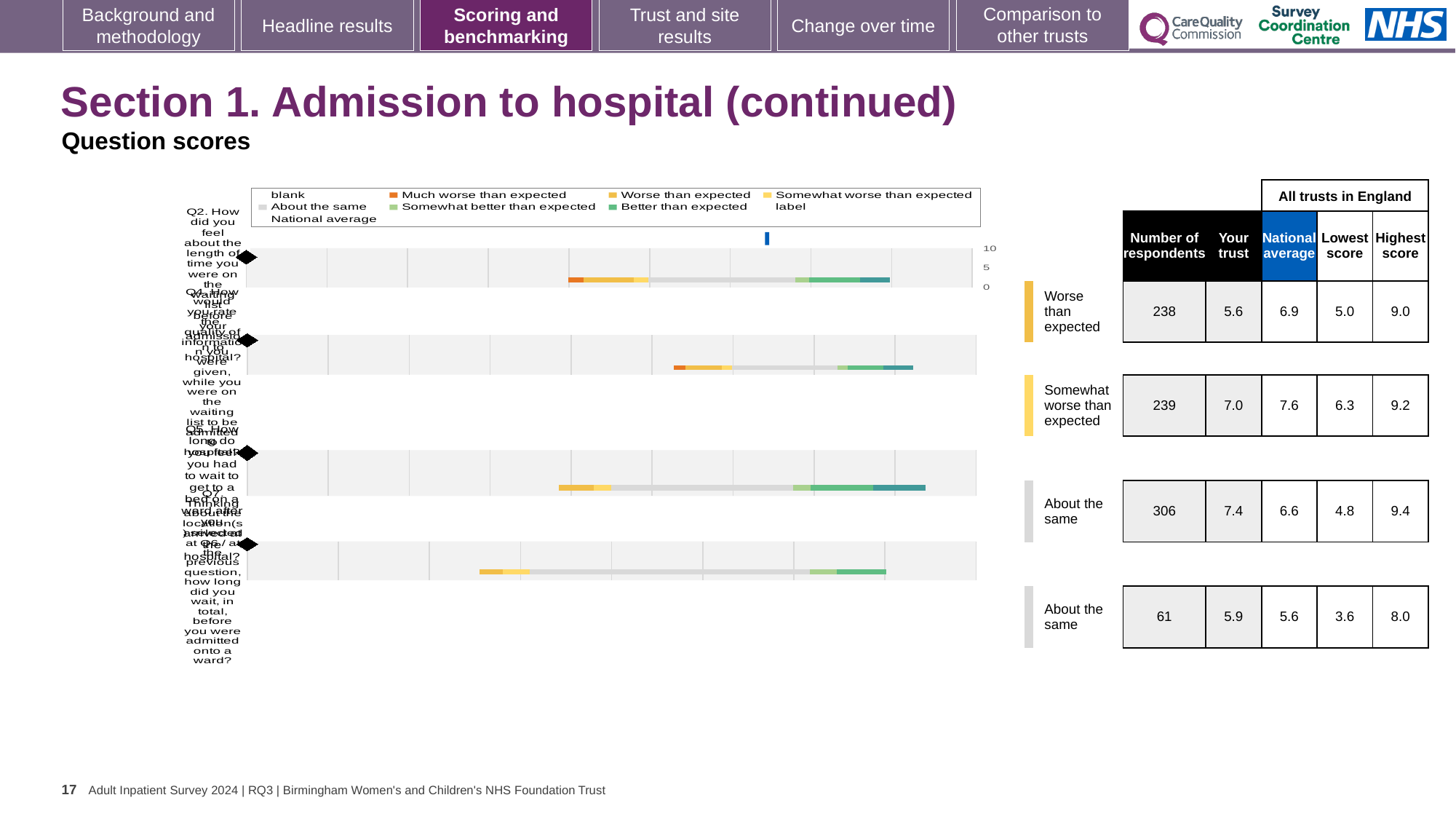
In the table, what is the 'Your trust' score for the row labelled 'Somewhat worse than expected'? 7.0 In the table, what is the national average for the row labelled 'Worse than expected'? 6.9 In the table, which row has the most respondents? the row with 306 respondents (About the same) In the table, what is the 'Your trust' score for the row with 306 respondents? 7.4 In the table, what is the highest score for the row with 61 respondents? 8.0 What kind of chart is shown on the slide? bar chart In the table, what is the difference between the 'Your trust' score and the national average for the row labelled 'Worse than expected'? 1.3 In the table, what is the number of respondents for the row labelled 'Worse than expected'? 238 Which colour in the legend represents 'Much worse than expected'? orange How many horizontal bars are plotted in the chart? 4 What is the maximum value shown on the chart's axis? 10 In the table, is the 'Your trust' score for the row labelled 'Somewhat worse than expected' larger or smaller than its national average? smaller